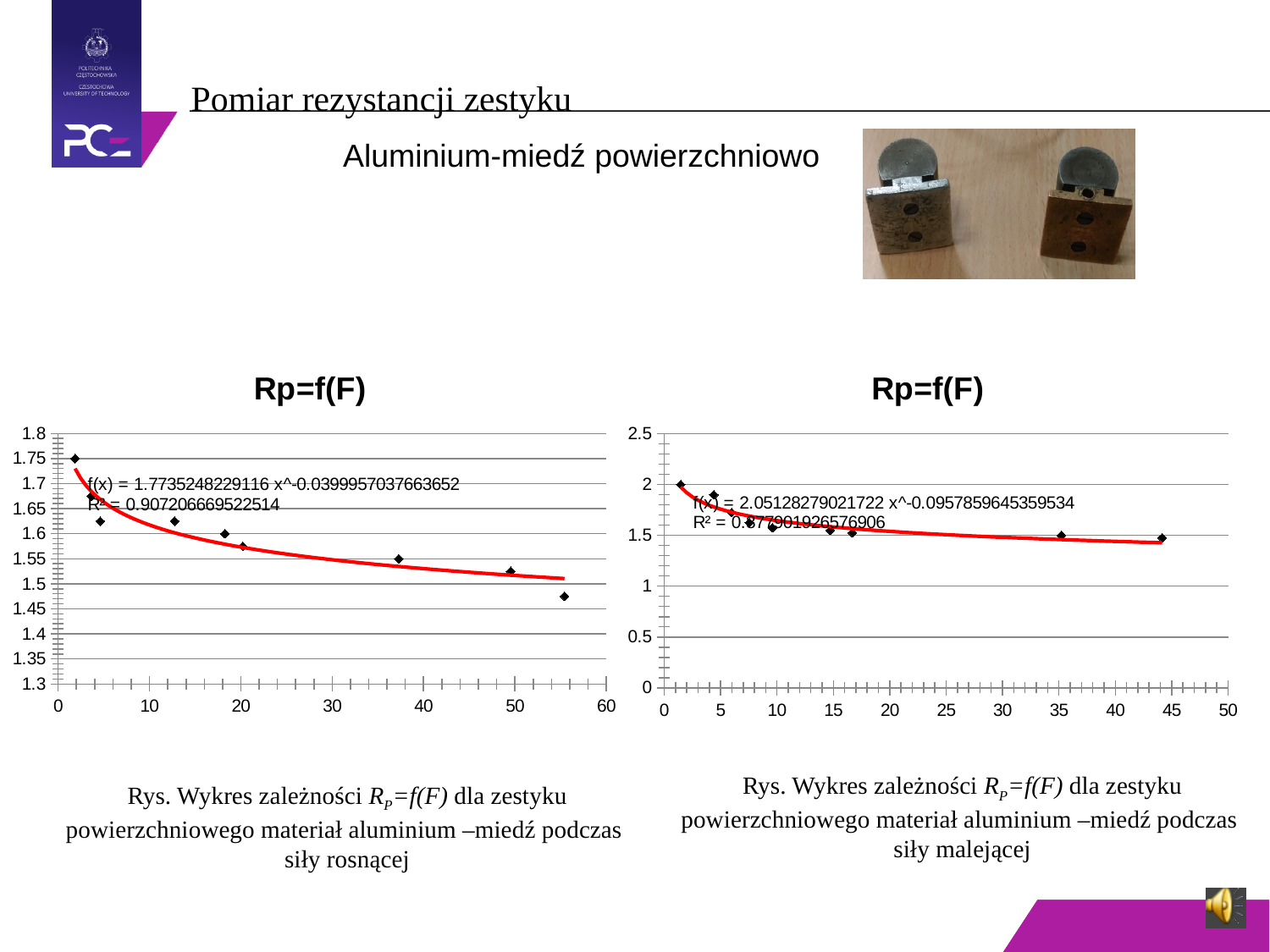
In the right chart, is the value of the rightmost data point greater or less than 1? greater What is the maximum value shown on the y axis of the right chart? 2.5 In the left chart, is the value of the first (leftmost) data point greater or less than 1.7? greater In the right chart (siły malejącej), do the Rp values rise or fall as F increases along the x axis? fall In the left chart, which data point has the larger Rp value, the leftmost or the rightmost? the leftmost How many data points are plotted in the left chart? 9 How many data points are plotted in the right chart? 9 In the left chart (siły rosnącej), do the Rp values rise or fall as F increases along the x axis? fall In the left chart, is the value of the last (rightmost) data point greater or less than 1.5? less What R² value is printed on the left chart? R² = 0.907206669522514 What kind of chart is the left chart titled Rp=f(F)? scatter chart